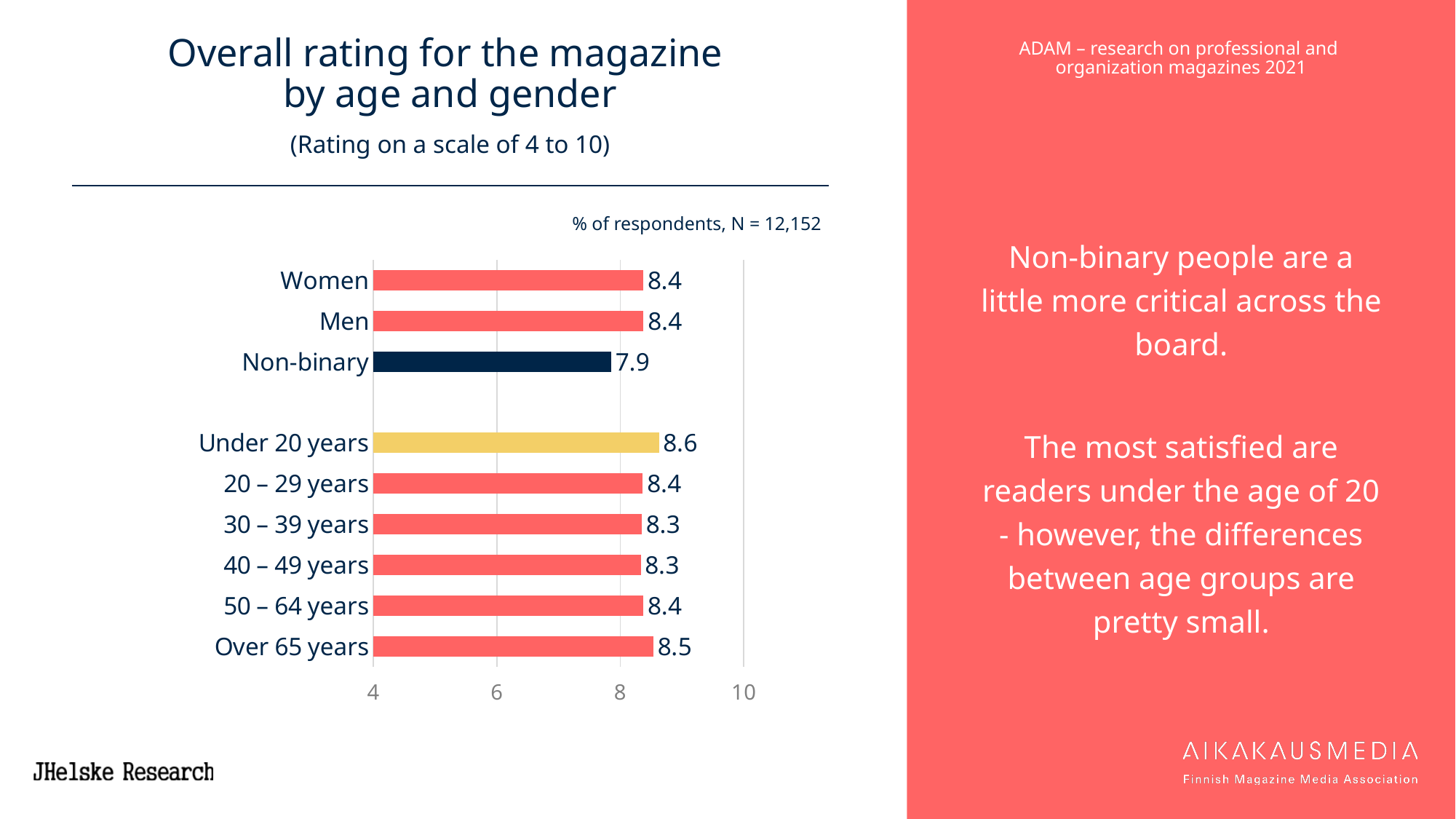
Which has a higher rating, Over 65 years or 40 – 49 years? Over 65 years What is the difference between the rating for Under 20 years and the rating for Non-binary respondents? 0.7 What is the number of respondents (N) stated above the chart? 12,152 What is the overall rating for Non-binary respondents? 7.9 What is the overall rating for Women? 8.4 What is the overall rating for the 30 – 39 years group? 8.3 Which age group has the highest rating? Under 20 years What is the overall rating for readers Over 65 years? 8.5 What is the overall rating for readers Under 20 years? 8.6 What kind of chart is shown on the slide? Bar chart How many categories are shown in the chart? 9 Which category has the lowest rating? Non-binary